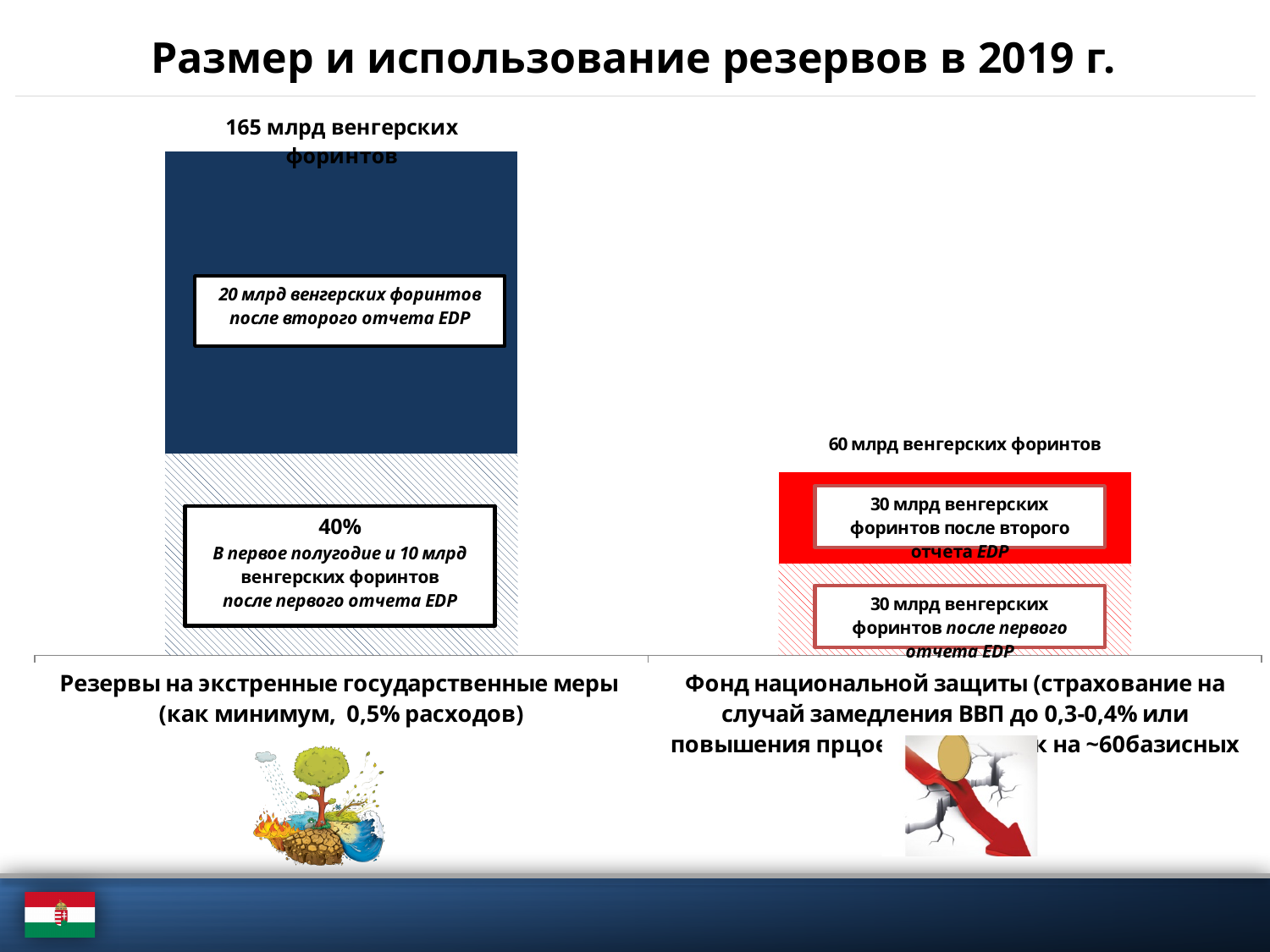
Which category has the highest total value? Резервы на экстренные государственные меры What is the difference between the total for 'Резервы на экстренные государственные меры' (165 млрд) and the total for 'Фонд национальной защиты' (60 млрд)? 105 млрд венгерских форинтов What kind of chart is shown on the slide? Stacked bar chart What is the total value labelled above the bar for 'Резервы на экстренные государственные меры'? 165 млрд венгерских форинтов Which category has the lowest total value? Фонд национальной защиты In the 'Фонд национальной защиты' bar, how much is labelled as used after the first EDP report? 30 млрд венгерских форинтов How many categories (bars) does the chart show? 2 What is the total value labelled above the bar for 'Фонд национальной защиты'? 60 млрд венгерских форинтов What is the title of the slide containing the chart? Размер и использование резервов в 2019 г. What colour is the solid segment of the 'Фонд национальной защиты' bar? Red Which is larger: the total for 'Резервы на экстренные государственные меры' or for 'Фонд национальной защиты'? Резервы на экстренные государственные меры In the 'Фонд национальной защиты' bar, how much is labelled as used after the second EDP report? 30 млрд венгерских форинтов